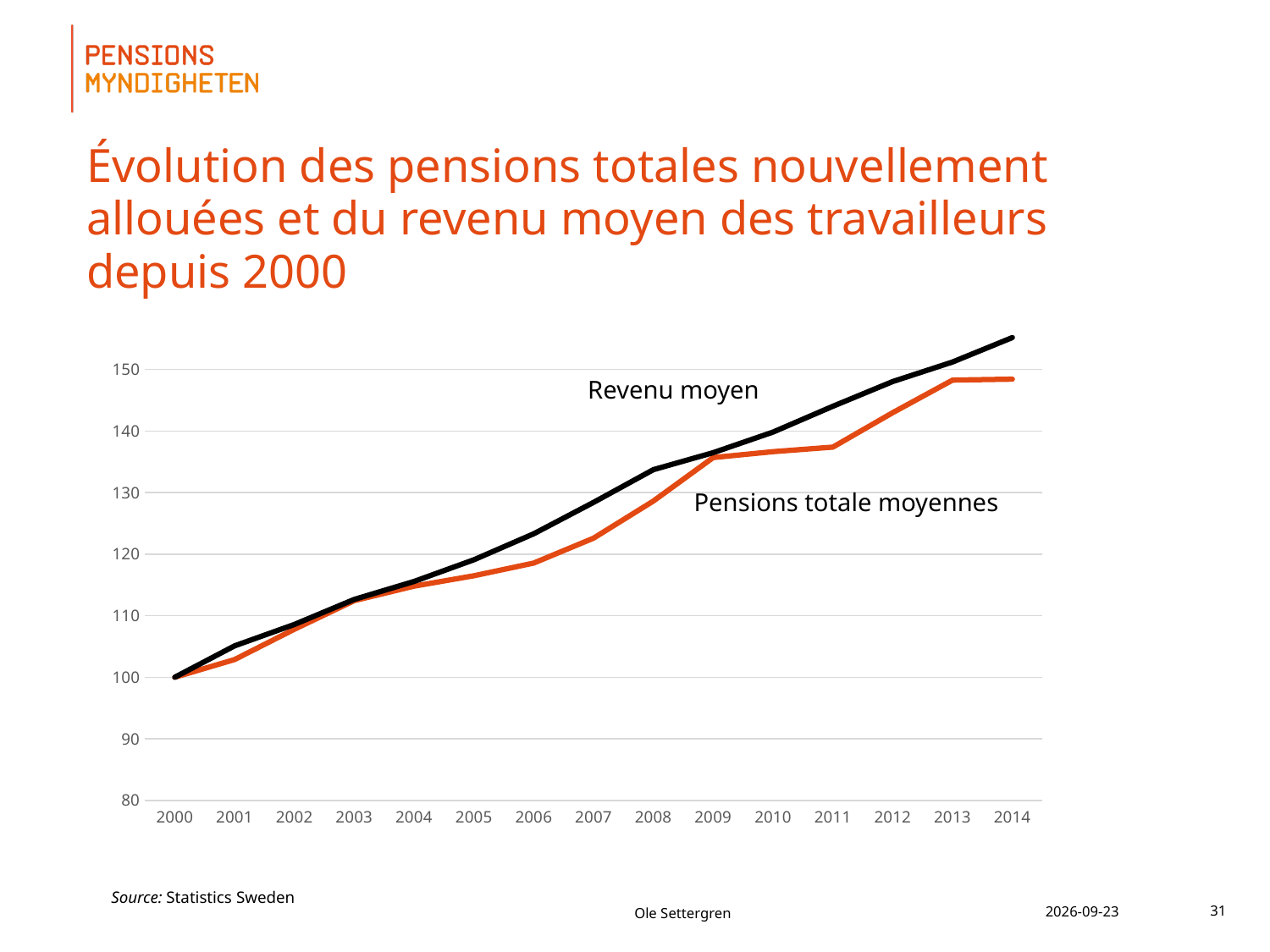
What is the value of Pensions totale moyennes in 2000? 100 What colour is the Revenu moyen line? black Is the value for Pensions totale moyennes in 2010 greater or less than 140? less What kind of chart is shown on the slide? line chart How many series are plotted on the chart? 2 How many years are shown along the x axis of the chart? 15 Is the value for Revenu moyen in 2014 greater or less than 150? greater Is the value for Revenu moyen in 2008 greater or less than 130? greater In 2014, which series has the higher value, Revenu moyen or Pensions totale moyennes? Revenu moyen Does the Revenu moyen line rise or fall from 2000 to 2014? rise What is the value of Revenu moyen in 2000? 100